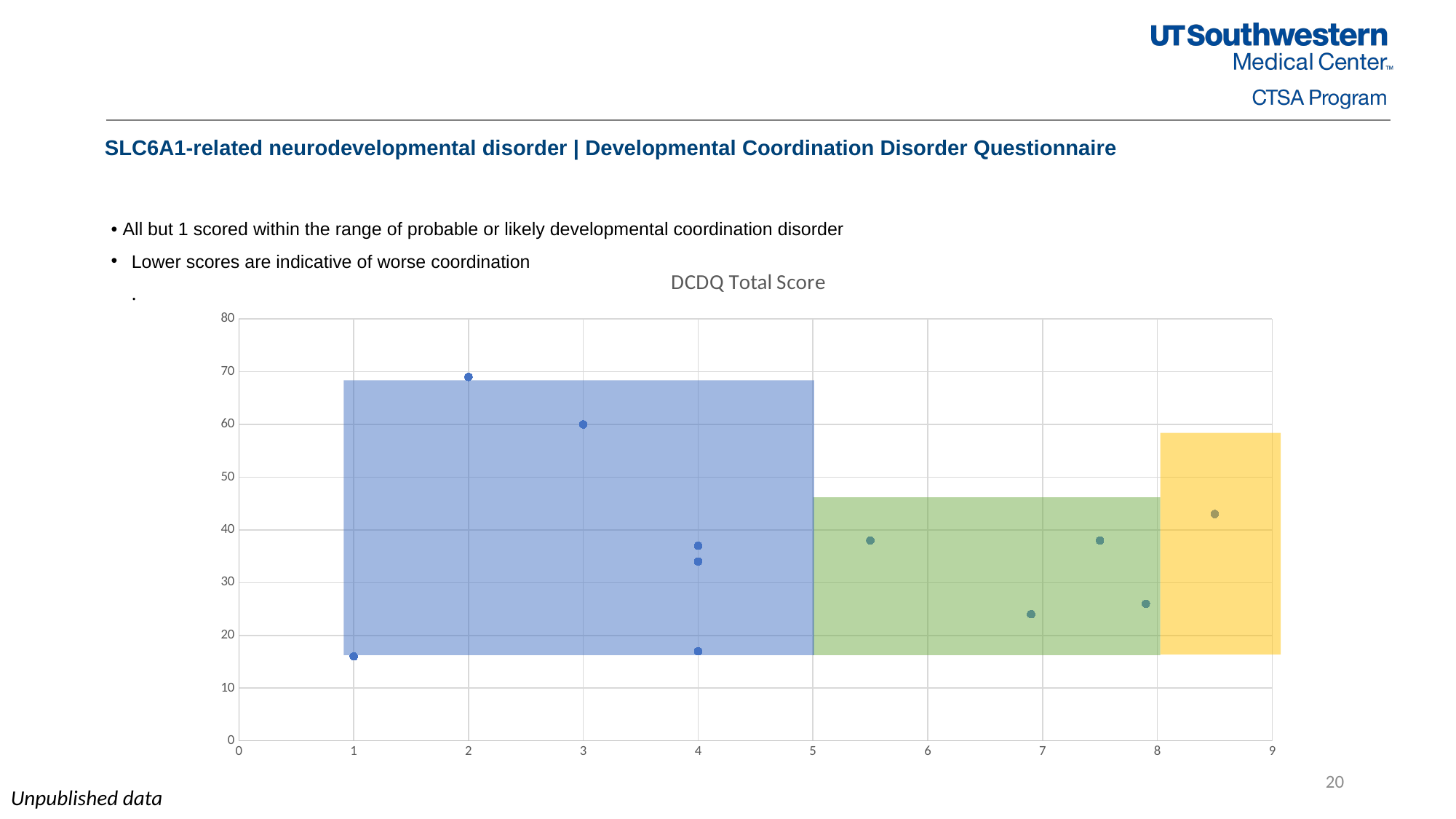
At which x-axis position is the highest plotted point? 2 Is the value of the point at x = 2 greater or less than 60? greater Which point has the larger value: the one at x = 2 or the one at x = 3? x = 2 What kind of chart is shown on the slide? scatter chart How many shaded background regions are drawn on the chart? 3 What is the title of the chart? DCDQ Total Score How many data points are plotted on the chart? 11 Is the value of the point near x = 7 greater or less than 30? less Which point has the larger value: the one at x = 8.5 or the one near x = 7? x = 8.5 Is the value of the point at x = 1 greater or less than 20? less